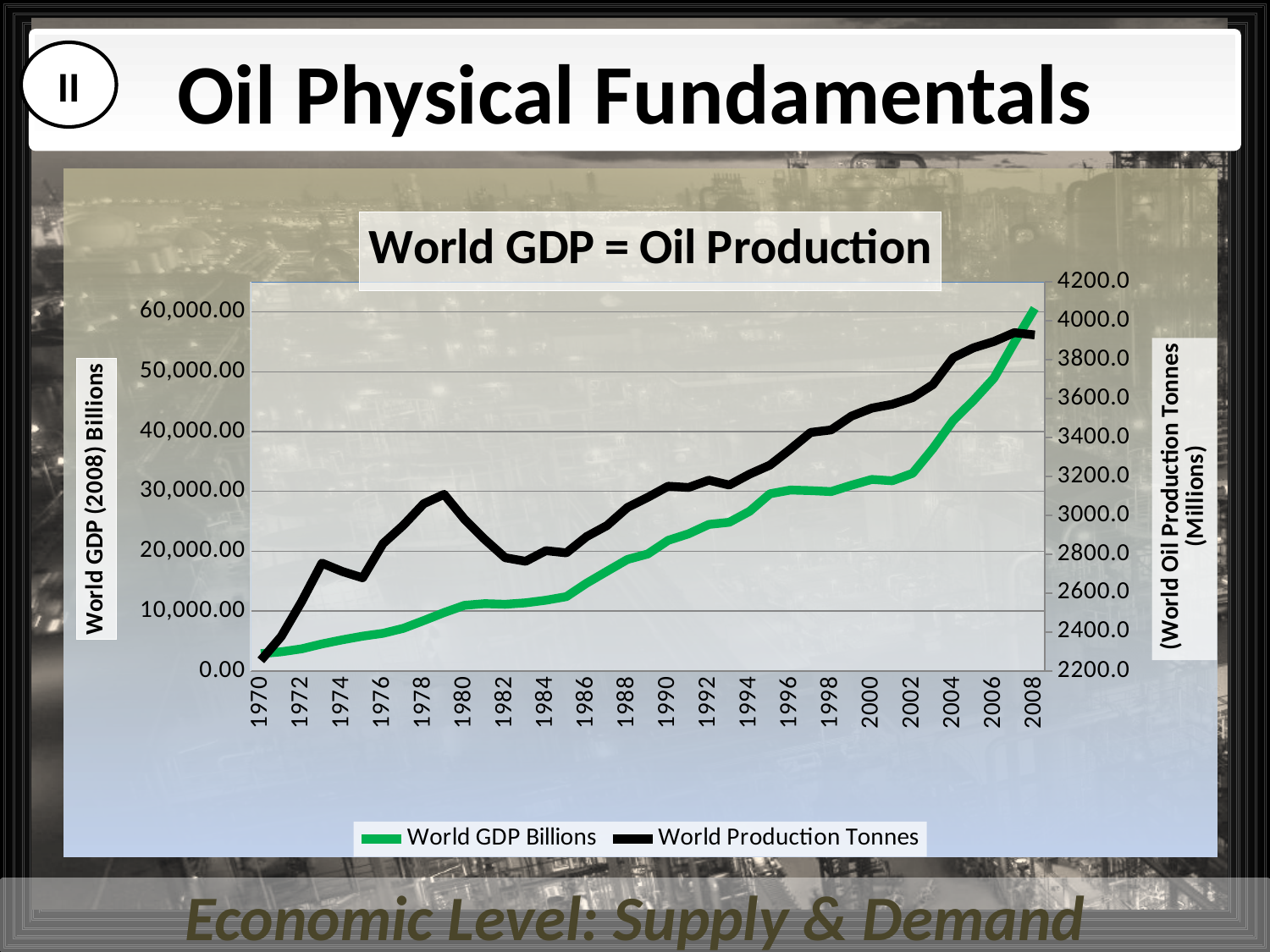
Is the value for World GDP Billions in 1986 greater or less than 20,000.00? less What is the title of the chart? World GDP = Oil Production What kind of chart is shown on the slide? line chart In which year is World GDP Billions at its highest? 2008 Is the value for World Production Tonnes in 2000 greater or less than 3400.0? greater Is the value for World GDP Billions in 2008 greater or less than 50,000.00? greater Which series is drawn in green? World GDP Billions Does World GDP Billions generally rise or fall from 1970 to 2008? rise How many series does the legend list? 2 Which is larger, World Production Tonnes in 1979 or in 1983? 1979 In which year is World Production Tonnes at its lowest? 1970